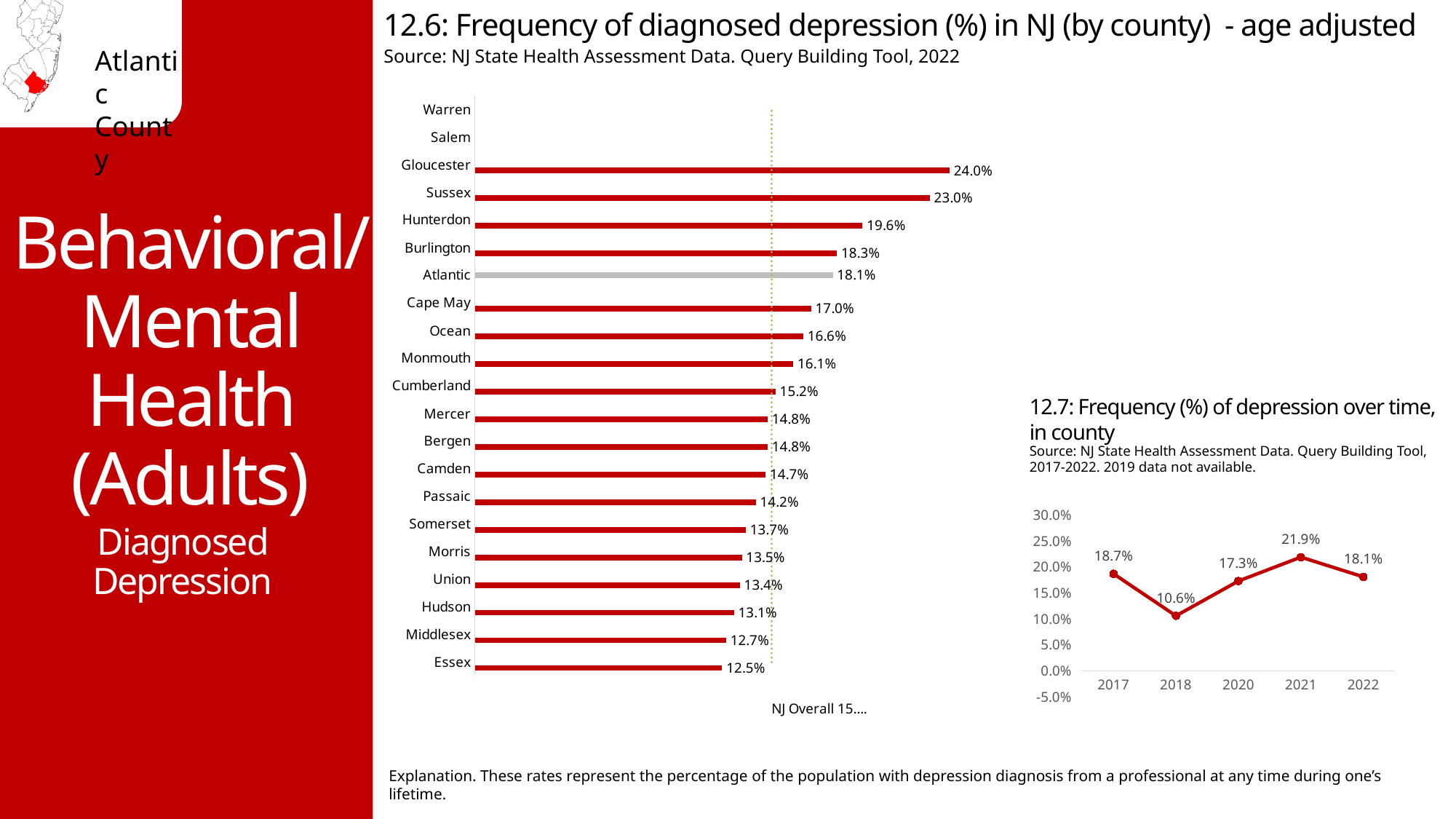
In chart 12.6, which county has a higher value, Hunterdon or Burlington? Hunterdon What kind of chart is chart 12.6? Bar chart In chart 12.7, what is the frequency of depression in 2021? 21.9% In chart 12.6, what is the frequency of diagnosed depression for Gloucester county? 24.0% In chart 12.7, how many years are plotted? 5 In chart 12.6, which county has the highest frequency of diagnosed depression? Gloucester In chart 12.7, is the value for 2018 greater or less than 15.0%? less In chart 12.7, what is the difference between the 2021 and 2022 values? 3.8% In chart 12.6, what is the value shown for Atlantic county? 18.1% In chart 12.6, what is the difference between the values for Gloucester and Sussex? 1.0% In chart 12.7, which year has the lowest frequency of depression? 2018 In chart 12.6, which county with a plotted bar has the lowest frequency of diagnosed depression? Essex